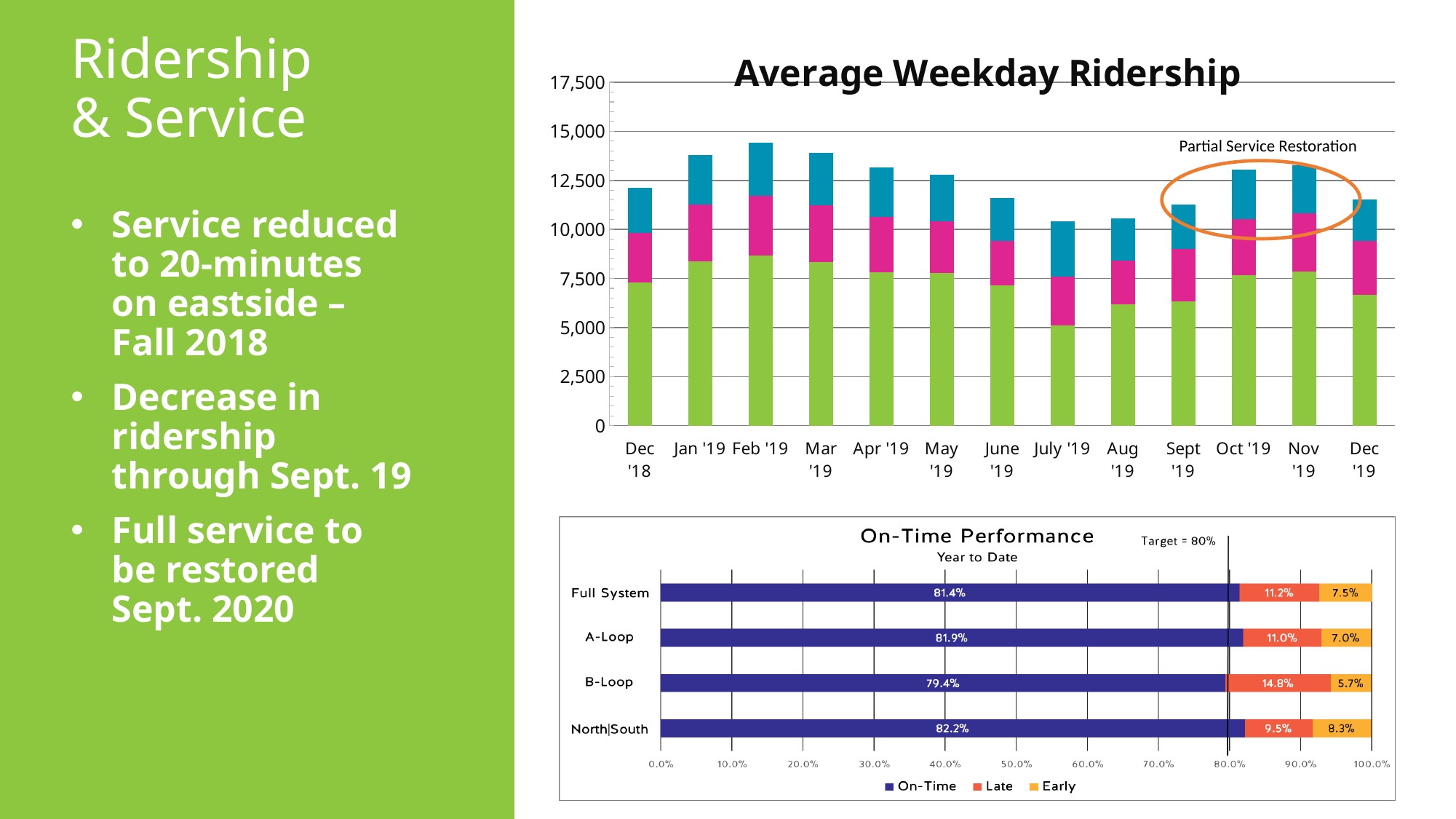
How many series does the legend of the On-Time Performance chart list? 3 In the On-Time Performance chart, what is the Late percentage for North|South? 9.5% In the Average Weekday Ridership chart, is the total for Dec '18 greater or less than 10,000? greater In the Average Weekday Ridership chart, which month has the highest total ridership? Feb '19 In the On-Time Performance chart, what is the On-Time percentage for B-Loop? 79.4% In the Average Weekday Ridership chart, do total ridership values rise or fall from Feb '19 to July '19? fall In the On-Time Performance chart, which category has the highest On-Time percentage? North|South What kind of chart is the Average Weekday Ridership chart? bar chart How many months are shown on the x axis of the Average Weekday Ridership chart? 13 In the On-Time Performance chart, what is the difference between the On-Time percentages of Full System and B-Loop? 2.0% In the Average Weekday Ridership chart, is the total for July '19 greater or less than 12,500? less What target value is noted on the On-Time Performance chart? Target = 80%